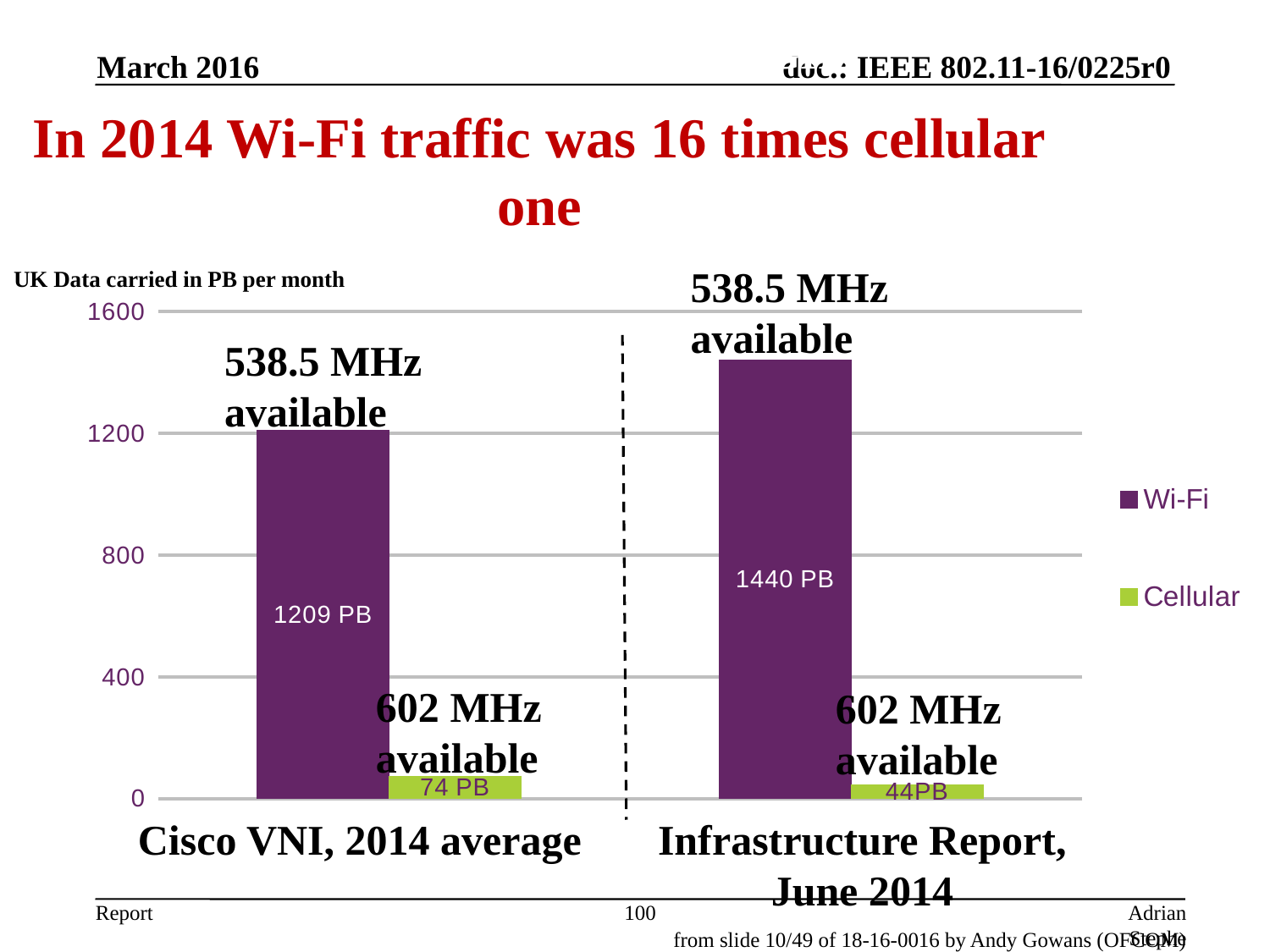
What is the Cellular value for Infrastructure Report, June 2014? 44PB What kind of chart is shown on the slide? bar chart What is the Cellular value for Cisco VNI, 2014 average? 74 PB Which category has the lower Cellular value? Infrastructure Report, June 2014 Is the Wi-Fi value for Cisco VNI, 2014 average greater or less than 1200? greater What is the difference between the Wi-Fi values for Infrastructure Report, June 2014 and Cisco VNI, 2014 average? 231 PB Is the Cellular value for Cisco VNI, 2014 average larger or smaller than the Cellular value for Infrastructure Report, June 2014? larger What is the Wi-Fi value for Infrastructure Report, June 2014? 1440 PB Which category has the higher Wi-Fi value? Infrastructure Report, June 2014 What is the label above the chart describing the data? UK Data carried in PB per month How many series does the legend list? 2 What is the Wi-Fi value for Cisco VNI, 2014 average? 1209 PB